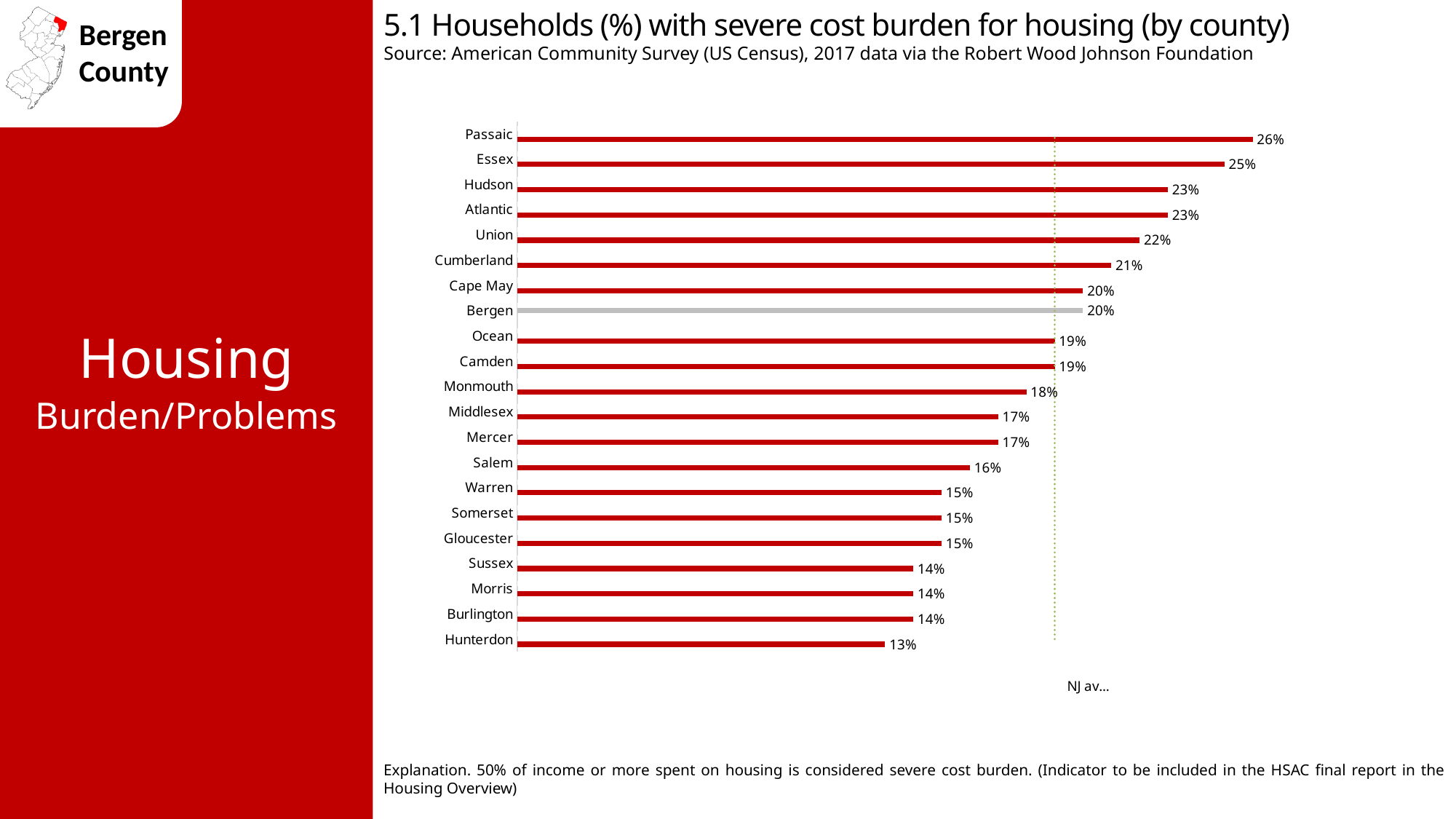
Which county has the highest value? Passaic What is the difference between the values for Essex and Bergen? 5% What is the value for Cumberland? 21% How many counties are shown in the chart? 21 Which county's bar is shown in grey rather than red? Bergen What is the difference between the values for Passaic and Hunterdon? 13% What is the value for Passaic? 26% Which is larger, the value for Union or the value for Salem? Union Which county has the lowest value? Hunterdon What is the value for Bergen? 20% What is the value for Hunterdon? 13% What kind of chart is this? Bar chart